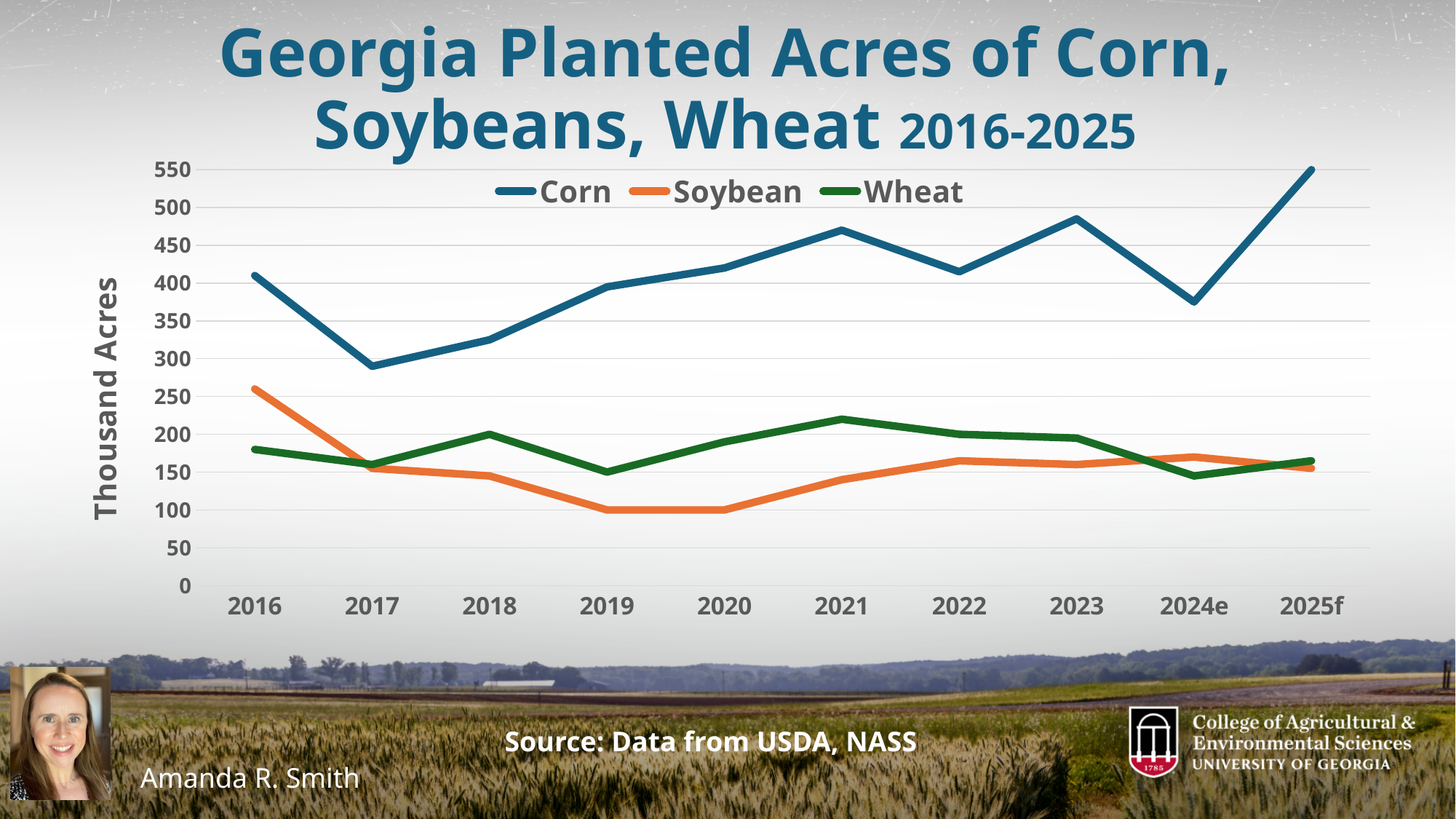
In which year is the Corn line at its highest? 2025f What kind of chart is shown on the slide? line chart Is the value for Soybean in 2016 greater or less than 200? greater Does the Corn line rise or fall from 2017 to 2021? rise How many years are shown along the x axis? 10 Is the value for Corn in 2021 greater or less than 450? greater Is the value for Corn in 2024e greater or less than 400? less In which year is the Corn line at its lowest? 2017 In 2021, which is larger, Wheat or Soybean? Wheat In 2024e, which is larger, Soybean or Wheat? Soybean In which year is the Wheat line at its highest? 2021 How many series does the legend list? 3